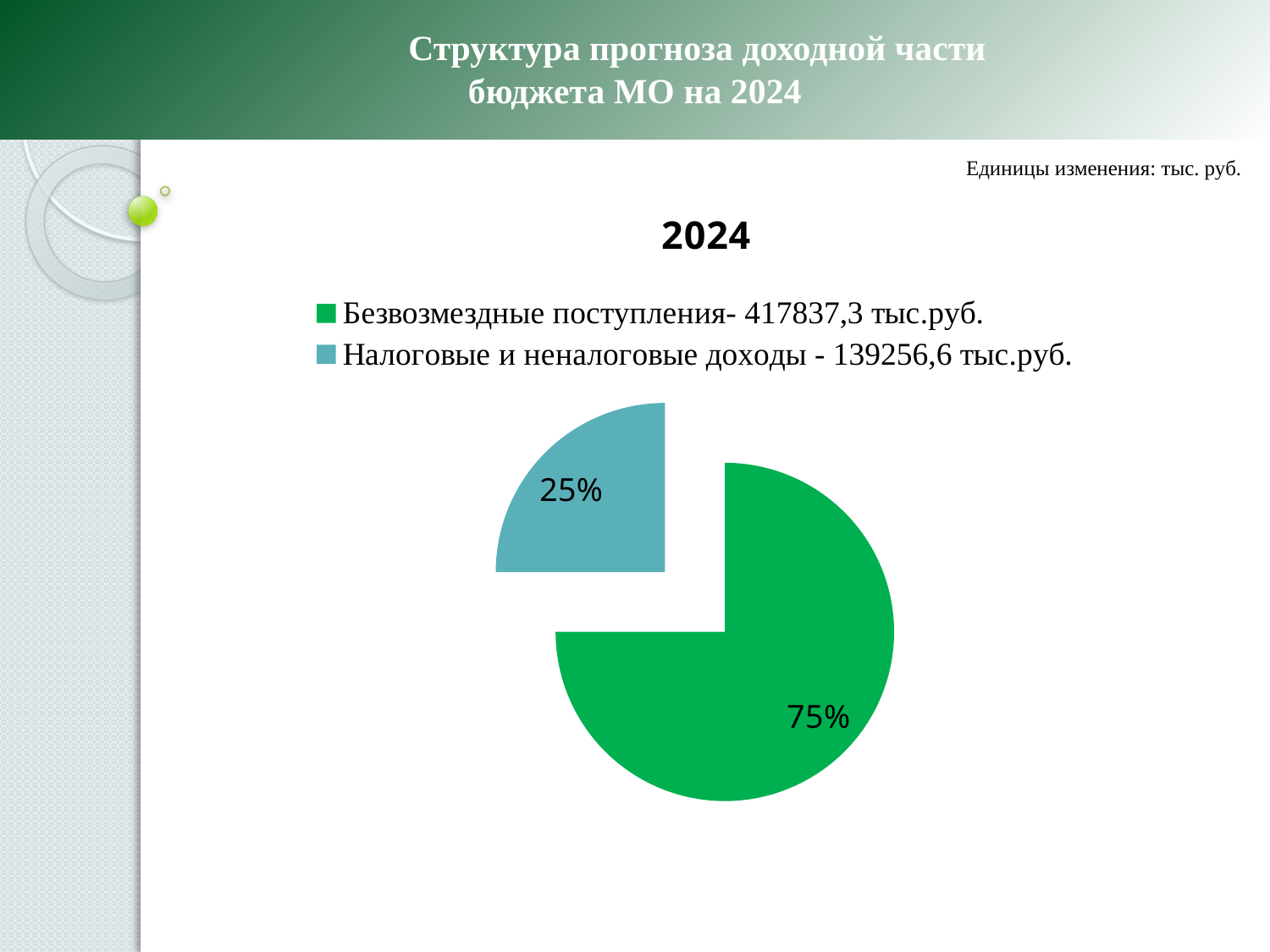
How many entries does the legend list? 2 What is the chart's title? 2024 What is the value for Безвозмездные поступления according to the legend? 417837,3 тыс.руб. What share of the pie does Безвозмездные поступления take? 75% What share of the pie does Налоговые и неналоговые доходы take? 25% Which is larger, Безвозмездные поступления or Налоговые и неналоговые доходы? Безвозмездные поступления How many slices does the pie chart have? 2 What kind of chart is shown on the slide? Pie chart What is the difference between the values for Безвозмездные поступления and Налоговые и неналоговые доходы? 278580,7 тыс.руб. Which category has the largest slice? Безвозмездные поступления Which category has the smallest slice? Налоговые и неналоговые доходы What is the value for Налоговые и неналоговые доходы according to the legend? 139256,6 тыс.руб.